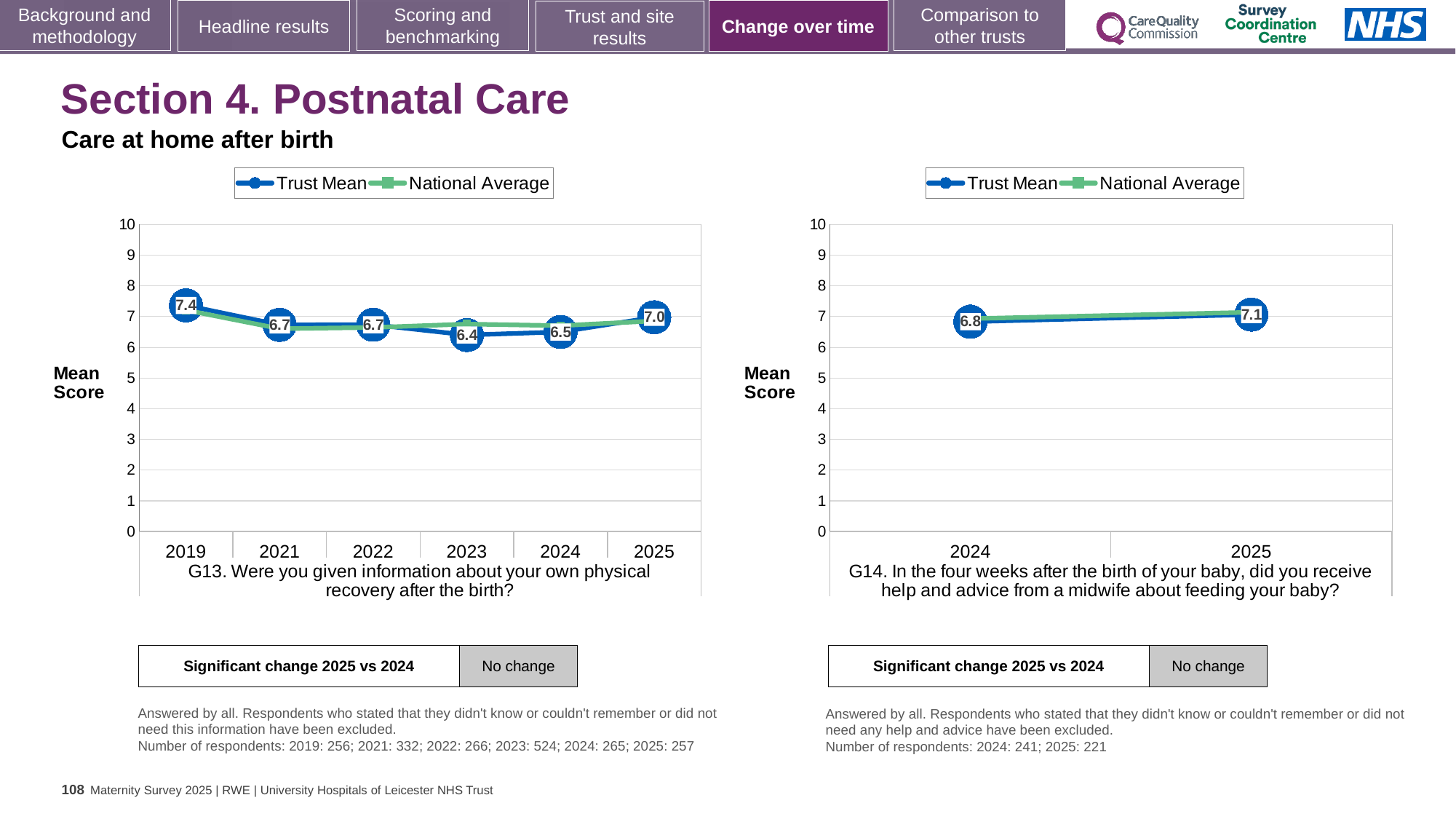
How many series does the legend of the G14 chart on the right list? 2 In the G13 chart on the left, what is the Trust Mean score for 2025? 7.0 In the G13 chart on the left, what is the difference between the Trust Mean scores for 2019 and 2023? 1.0 In the G13 chart on the left, what is the Trust Mean score for 2023? 6.4 In the G13 chart on the left, what is the Trust Mean score for 2019? 7.4 In the G13 chart on the left, how many years are plotted on the x axis? 6 In the G14 chart on the right, is the Trust Mean score higher in 2024 or 2025? 2025 In the G13 chart on the left, which year has the lowest Trust Mean score? 2023 In the G13 chart on the left, which year has the highest Trust Mean score? 2019 In the G14 chart on the right, what is the Trust Mean score for 2025? 7.1 In the G14 chart on the right, what is the difference between the Trust Mean scores for 2025 and 2024? 0.3 What kind of chart is the G13 chart on the left? Line chart